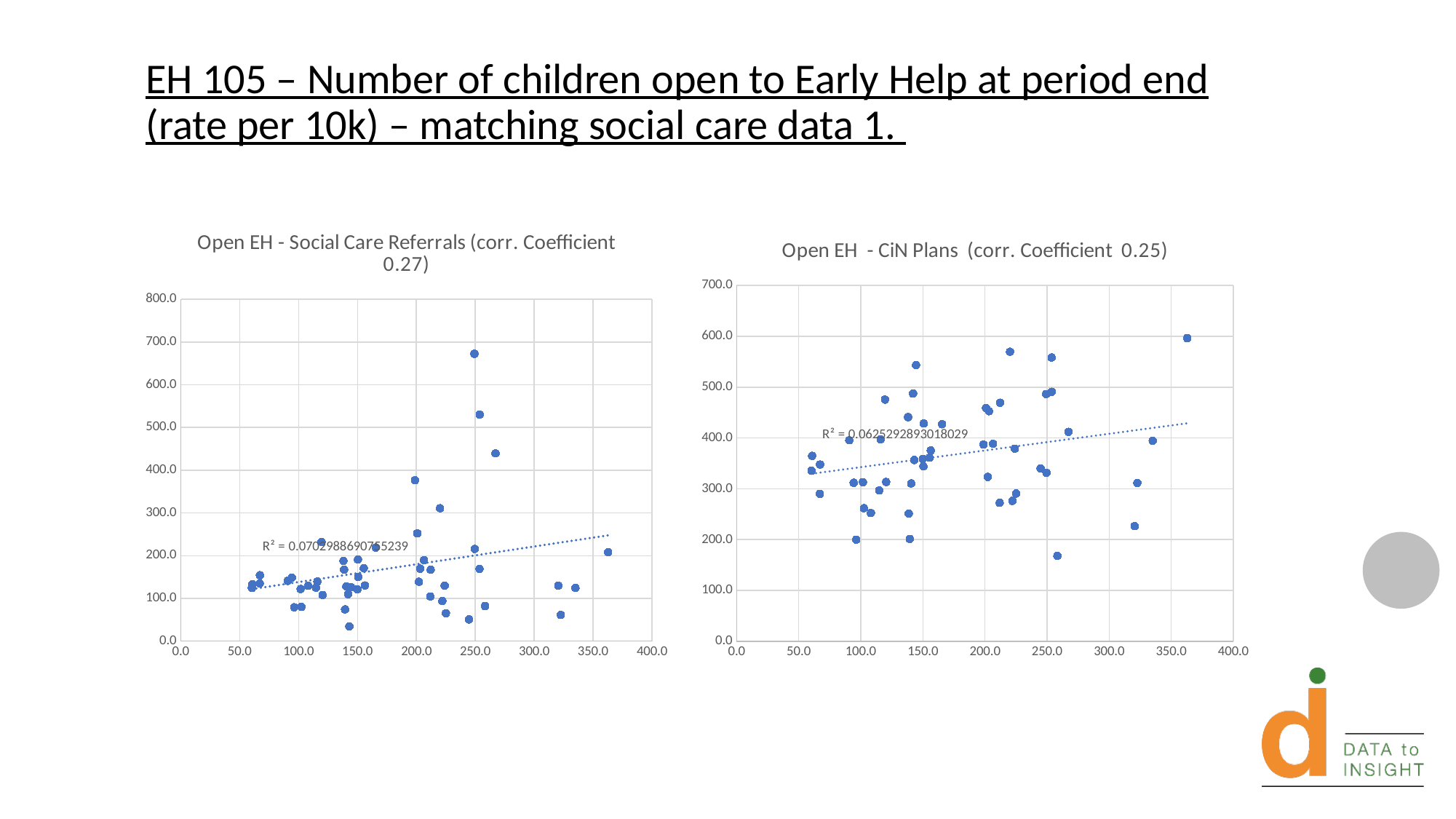
What kind of chart is the right chart titled 'Open EH - CiN Plans'? scatter chart In the right chart 'Open EH - CiN Plans', is the y value of the highest point greater or less than 500.0? greater In the left chart 'Open EH - Social Care Referrals', is the y value of the highest point greater or less than 600.0? greater In the right chart 'Open EH - CiN Plans', does the dotted trendline rise or fall as the x value increases? rise What is the maximum value shown on the y axis of the left chart 'Open EH - Social Care Referrals'? 800.0 In the left chart 'Open EH - Social Care Referrals', is the y value of the lowest point greater or less than 50.0? less In the right chart, what correlation coefficient is stated in the title? 0.25 In the right chart 'Open EH - CiN Plans', what R² value is printed next to the trendline? 0.0625292893018029 What kind of chart is the left chart titled 'Open EH - Social Care Referrals'? scatter chart In the left chart 'Open EH - Social Care Referrals', does the dotted trendline rise or fall as the x value increases? rise In the left chart, what correlation coefficient is stated in the title? 0.27